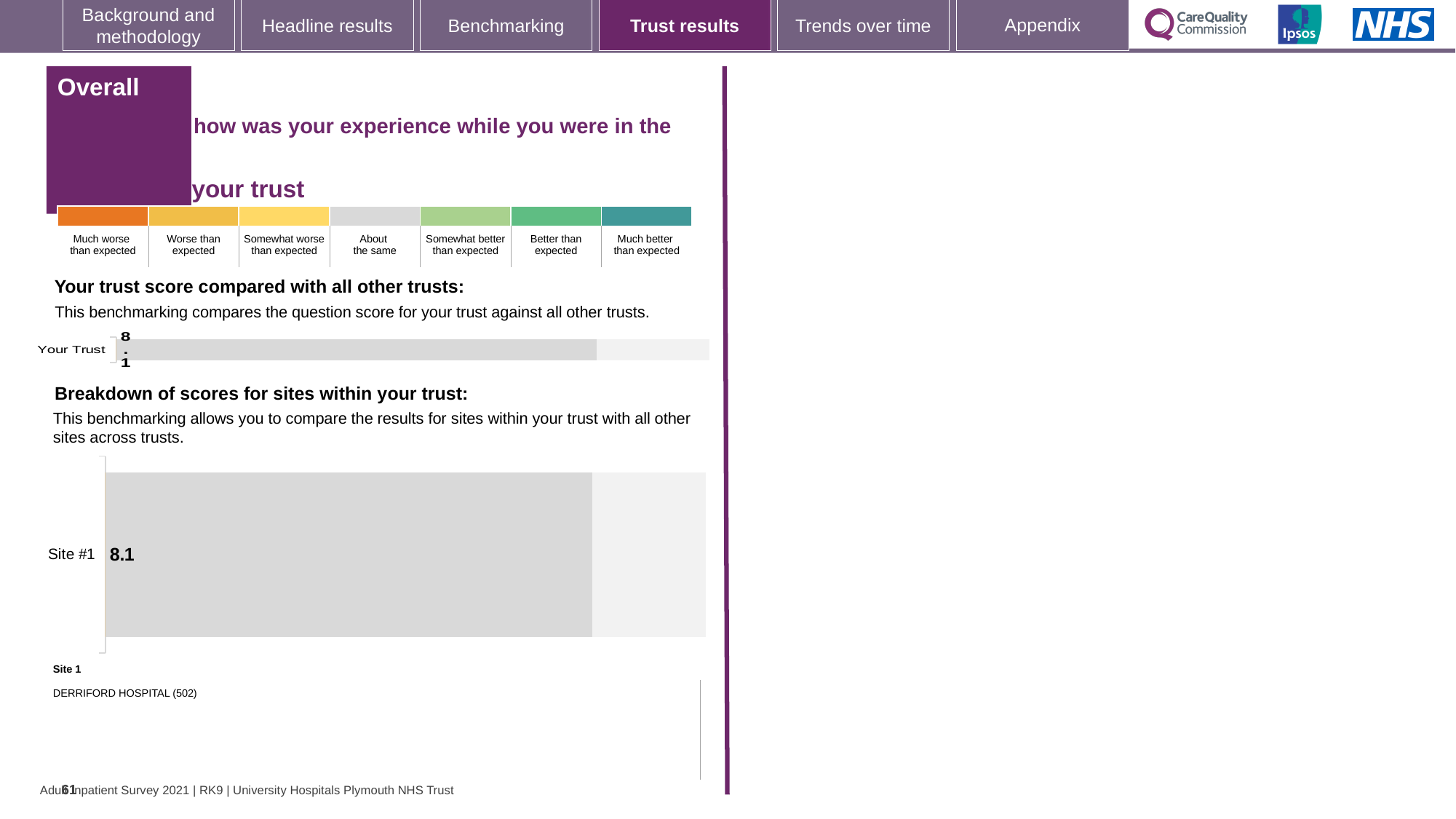
What kind of chart is the 'Your trust score compared with all other trusts' chart? bar chart How many bars are plotted in the 'Your trust score compared with all other trusts' chart? 1 What is the label of the single bar in the 'Your trust score compared with all other trusts' chart? Your Trust What kind of chart is the 'Breakdown of scores for sites within your trust' chart? bar chart How many sites are plotted in the 'Breakdown of scores for sites within your trust' chart? 1 In the 'Your trust score compared with all other trusts' chart, what is the score for Your Trust? 8.1 In the 'Breakdown of scores for sites within your trust' chart, what is the score for Site #1? 8.1 How many rating bands does the colour key above the charts show, from 'Much worse than expected' to 'Much better than expected'? 7